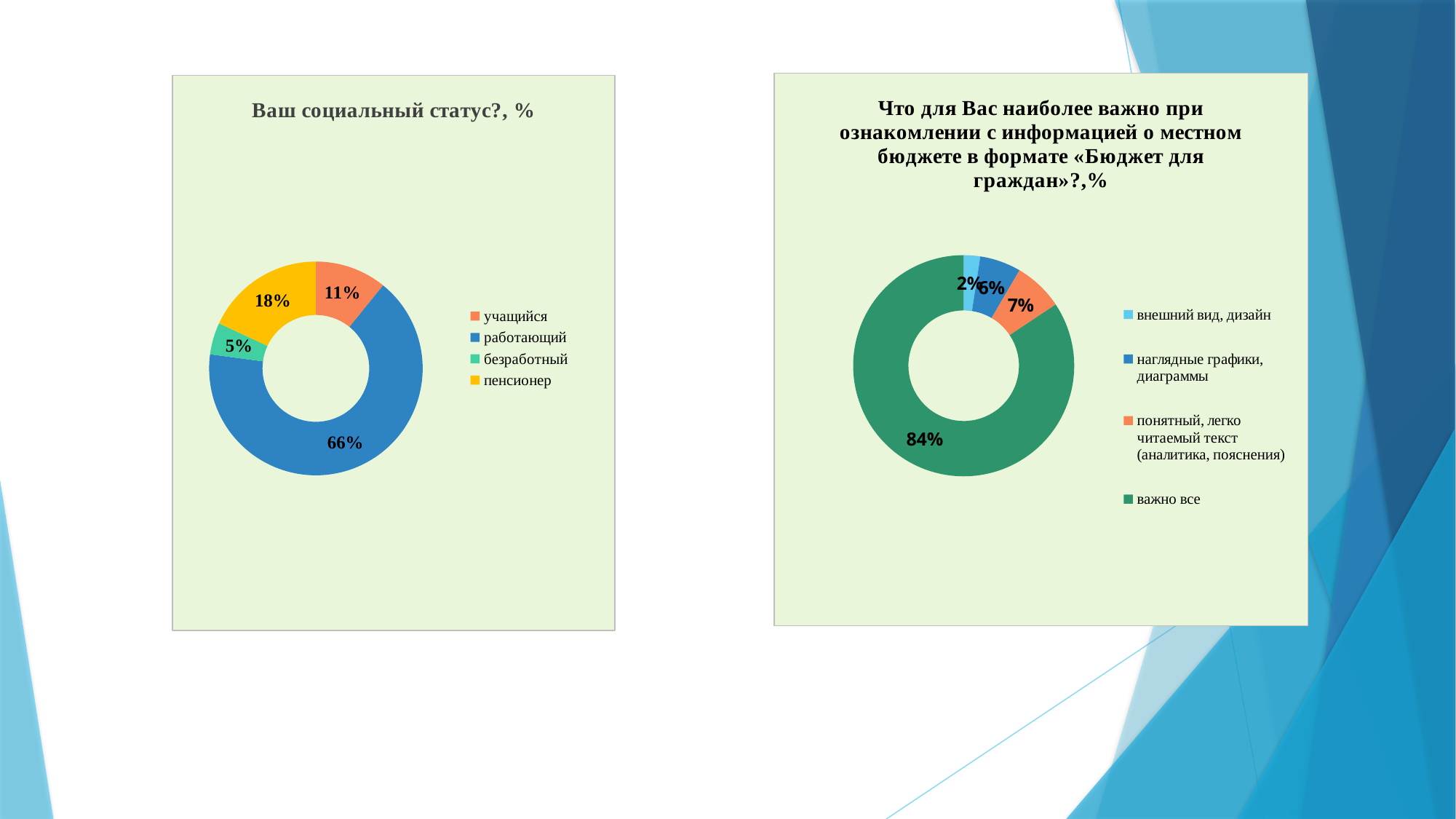
In the right chart about 'Бюджет для граждан', what is the difference between 'наглядные графики, диаграммы' and 'внешний вид, дизайн'? 4% In the right chart about 'Бюджет для граждан', which category has the smallest share? внешний вид, дизайн In the left chart 'Ваш социальный статус?, %', what is the value for 'пенсионер'? 18% In the left chart 'Ваш социальный статус?, %', which is larger: 'учащийся' or 'безработный'? учащийся In the right chart about 'Бюджет для граждан', what is the value for 'важно все'? 84% In the left chart 'Ваш социальный статус?, %', what is the difference between 'пенсионер' and 'учащийся'? 7% In the right chart about 'Бюджет для граждан', what colour is the 'важно все' slice? Green In the right chart about 'Бюджет для граждан', what is the value for 'понятный, легко читаемый текст (аналитика, пояснения)'? 7% In the left chart 'Ваш социальный статус?, %', what is the value for 'работающий'? 66% In the left chart 'Ваш социальный статус?, %', how many categories does the legend list? 4 What type of chart is the right chart about 'Бюджет для граждан'? Pie (doughnut) chart In the left chart 'Ваш социальный статус?, %', which category has the smallest share? безработный